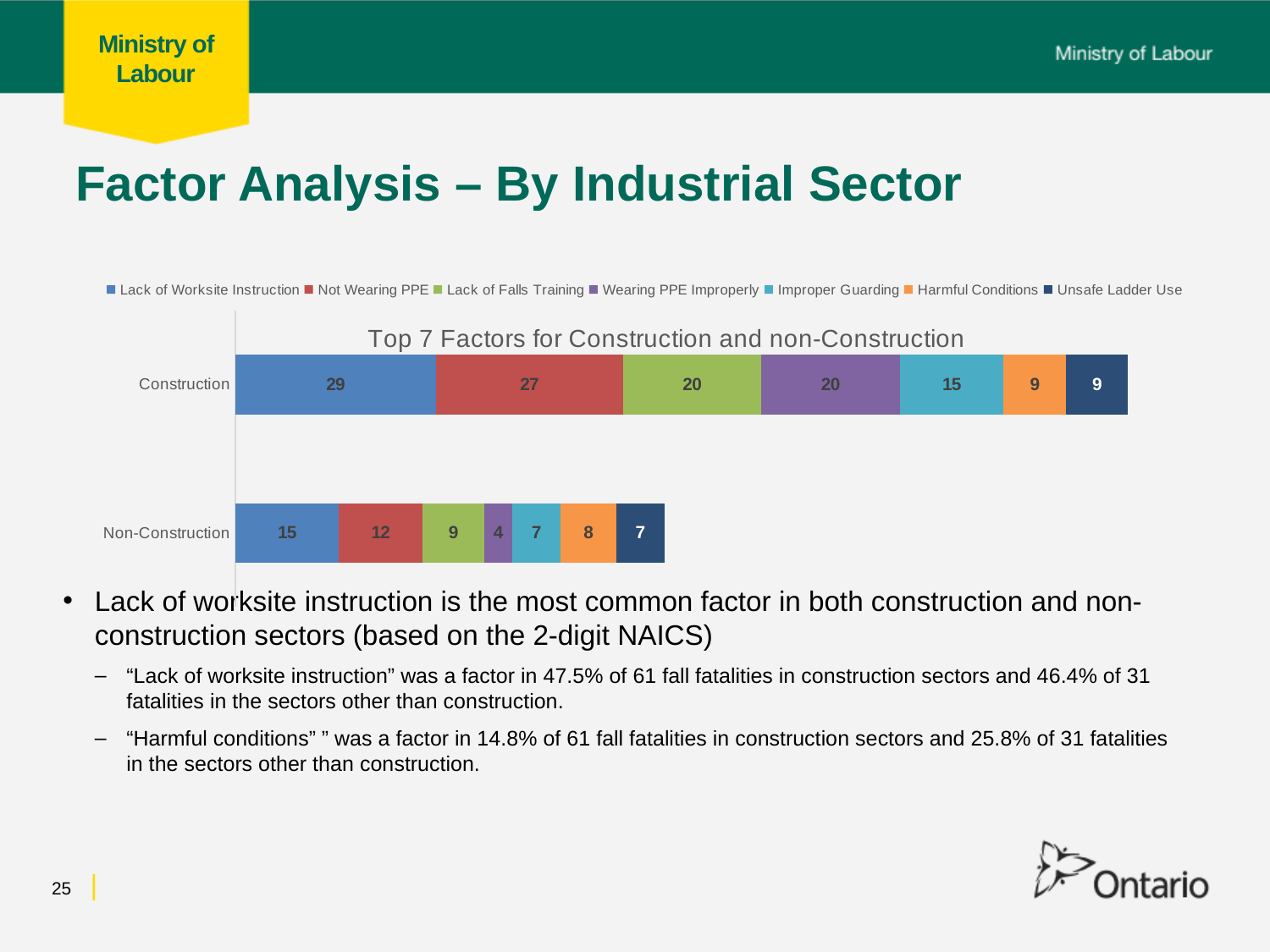
Which factor has the highest value in the Non-Construction bar? Lack of Worksite Instruction What is the total of the Non-Construction stacked bar? 62 How many series does the chart legend list? 7 How many categories (bars) are shown in the chart? 2 What is the value for Lack of Worksite Instruction in the Construction bar? 29 What is the value for Improper Guarding in the Construction bar? 15 What is the difference between the Lack of Worksite Instruction values for Construction and Non-Construction? 14 What is the title of the chart? Top 7 Factors for Construction and non-Construction What kind of chart is shown on the slide? Stacked bar chart Which factor has the lowest value in the Non-Construction bar? Wearing PPE Improperly What is the value for Wearing PPE Improperly in the Non-Construction bar? 4 What is the value for Not Wearing PPE in the Non-Construction bar? 12